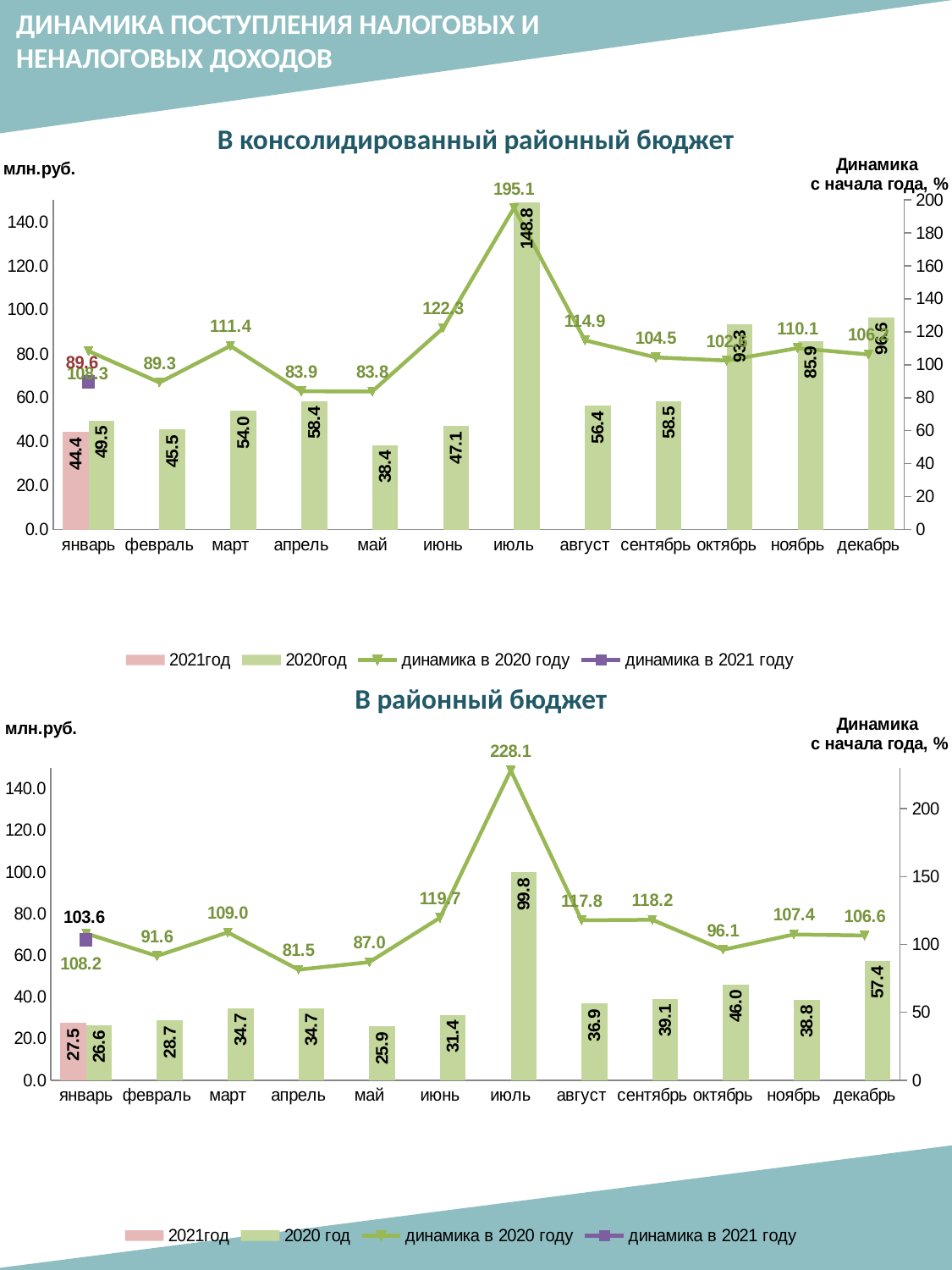
In the chart 'В районный бюджет', which month has the highest 'динамика в 2020 году' value? июль In the chart 'В районный бюджет', which is larger: the 2020 год value for октябрь or for ноябрь? октябрь In the chart 'В консолидированный районный бюджет', which month has the lowest 2020 год bar? май In the chart 'В консолидированный районный бюджет', what is the 'динамика в 2020 году' value for июнь? 122.3 In the chart 'В консолидированный районный бюджет', how many series does the legend list? 4 In the chart 'В консолидированный районный бюджет', what is the 2021год value for январь? 44.4 In the chart 'В районный бюджет', what is the 'динамика в 2021 году' value for январь? 103.6 In the chart 'В районный бюджет', what is the 2020 год value for декабрь? 57.4 In the chart 'В районный бюджет', how many months are shown on the x axis? 12 In the chart 'В консолидированный районный бюджет', what is the difference between the 2020 год values for апрель and май? 20.0 In the chart 'В районный бюджет', what is the difference between the 2021год and 2020 год values for январь? 0.9 In the chart 'В консолидированный районный бюджет', what is the 2020 год value for июль? 148.8